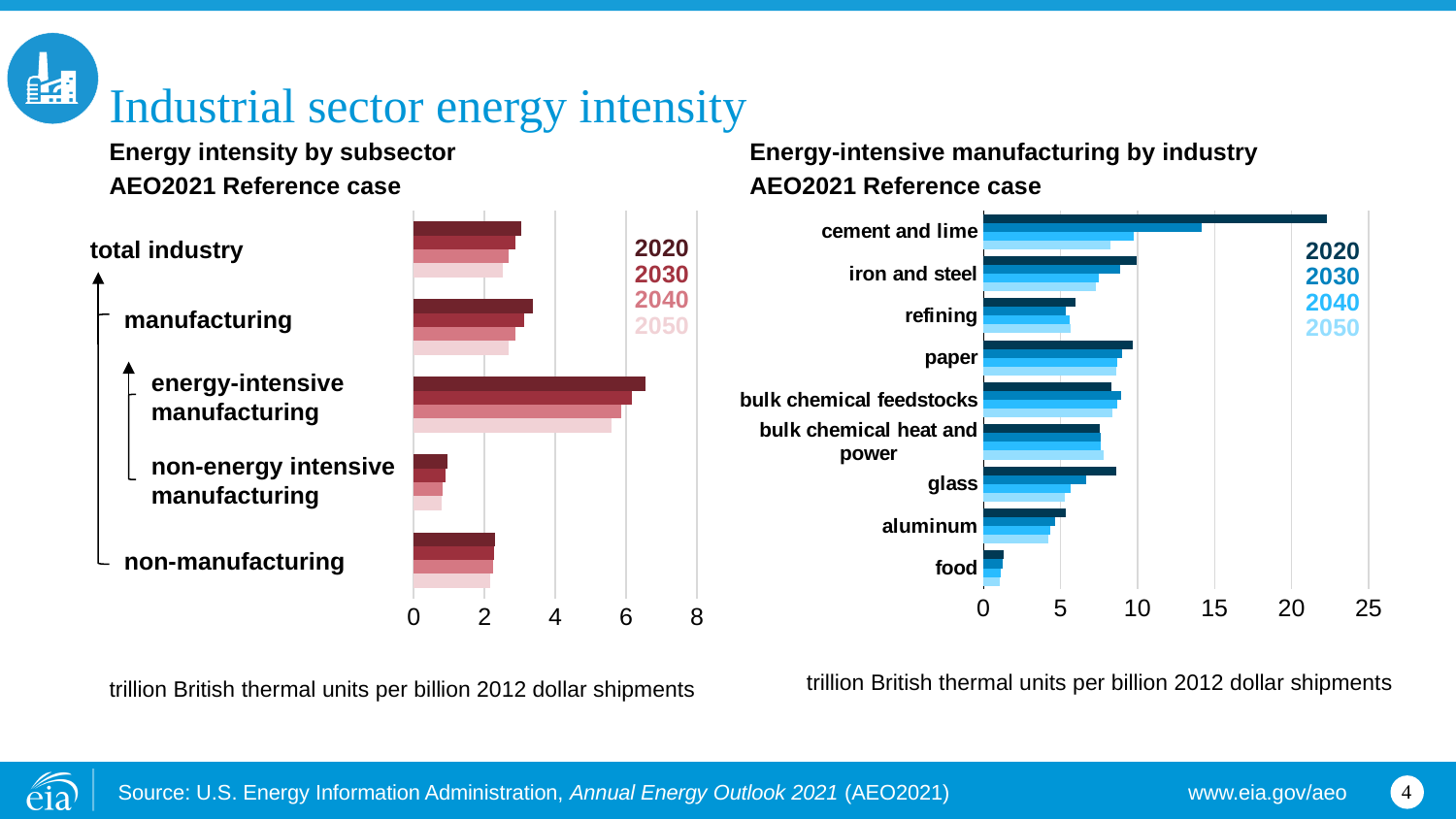
What kind of chart is the 'Energy intensity by subsector' chart on the left? bar chart In the 'Energy intensity by subsector' chart, which category has the highest 2020 value? energy-intensive manufacturing In the 'Energy-intensive manufacturing by industry' chart, does the value for cement and lime rise or fall from 2020 to 2050? fall How many series does the legend of the 'Energy-intensive manufacturing by industry' chart list? 4 In the 'Energy-intensive manufacturing by industry' chart, which industry has the highest 2020 value? cement and lime What unit is shown on the x axis of both charts? trillion British thermal units per billion 2012 dollar shipments How many subsector categories are shown in the 'Energy intensity by subsector' chart? 5 In the 'Energy-intensive manufacturing by industry' chart, is the 2020 value for cement and lime greater or less than 20? greater In the 'Energy intensity by subsector' chart, which category has the lowest 2020 value? non-energy intensive manufacturing In the 'Energy-intensive manufacturing by industry' chart, which industry has the lowest 2020 value? food How many industries are shown in the 'Energy-intensive manufacturing by industry' chart? 9 In the 'Energy intensity by subsector' chart, is the 2020 value for energy-intensive manufacturing greater or less than 6? greater